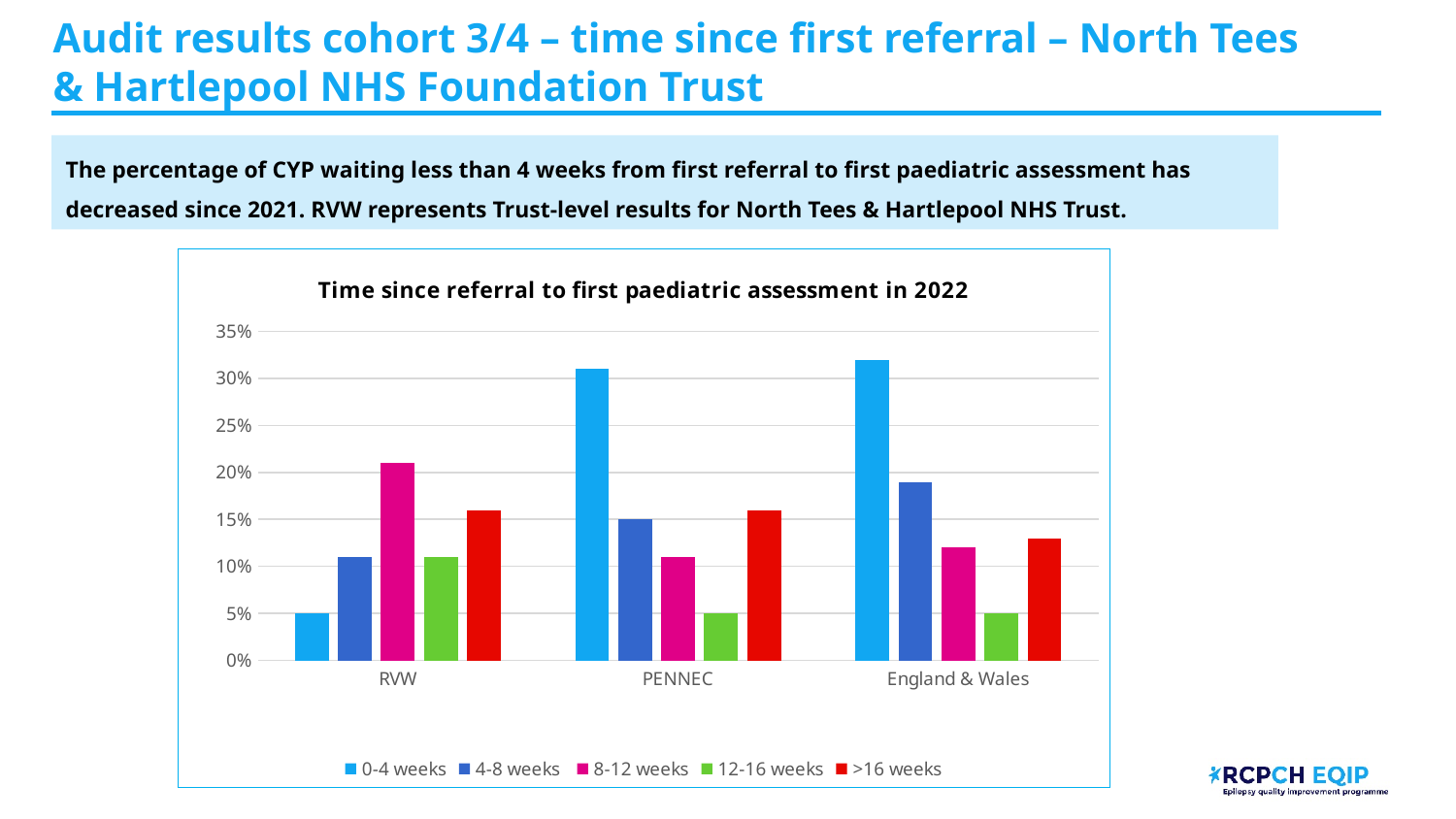
How many categories are shown on the x axis of the chart? 3 Which is larger: the 4-8 weeks value for England & Wales or the 4-8 weeks value for PENNEC? England & Wales For PENNEC, which waiting-time band has the highest value? 0-4 weeks What is the title of the chart? Time since referral to first paediatric assessment in 2022 Is the value for >16 weeks for England & Wales greater or less than 15%? less Is the value for 8-12 weeks for RVW greater or less than 15%? greater How many series does the chart's legend list? 5 For RVW, which waiting-time band has the lowest value? 0-4 weeks What kind of chart is shown on the slide? bar chart For RVW, which waiting-time band has the highest value? 8-12 weeks Is the value for 0-4 weeks for PENNEC greater or less than 25%? greater For England & Wales, which waiting-time band has the lowest value? 12-16 weeks